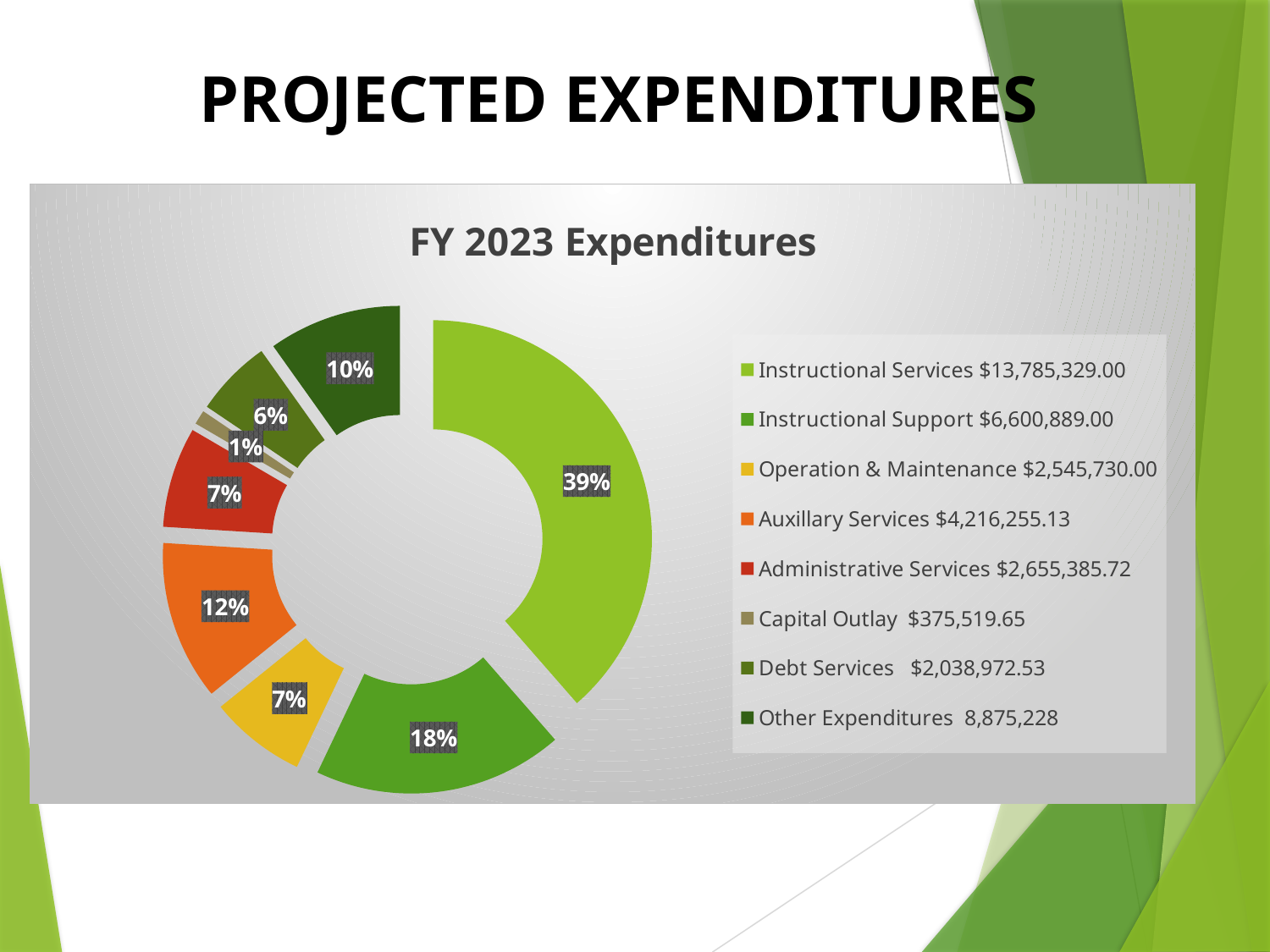
Which category has the largest slice in the FY 2023 Expenditures chart? Instructional Services Which slice is larger, Auxillary Services or Other Expenditures? Auxillary Services What dollar amount does the legend give for Debt Services? $2,038,972.53 What dollar amount does the legend give for Instructional Services? $13,785,329.00 How many categories are shown in the FY 2023 Expenditures chart? 8 What share of FY 2023 Expenditures does Instructional Support represent? 18% What share of FY 2023 Expenditures does Instructional Services represent? 39% What is the difference in percentage points between the Instructional Services slice and the Instructional Support slice? 21% What percentage of the FY 2023 Expenditures chart is Auxillary Services? 12% Which category has the smallest slice in the FY 2023 Expenditures chart? Capital Outlay What type of chart is used to show FY 2023 Expenditures? doughnut chart